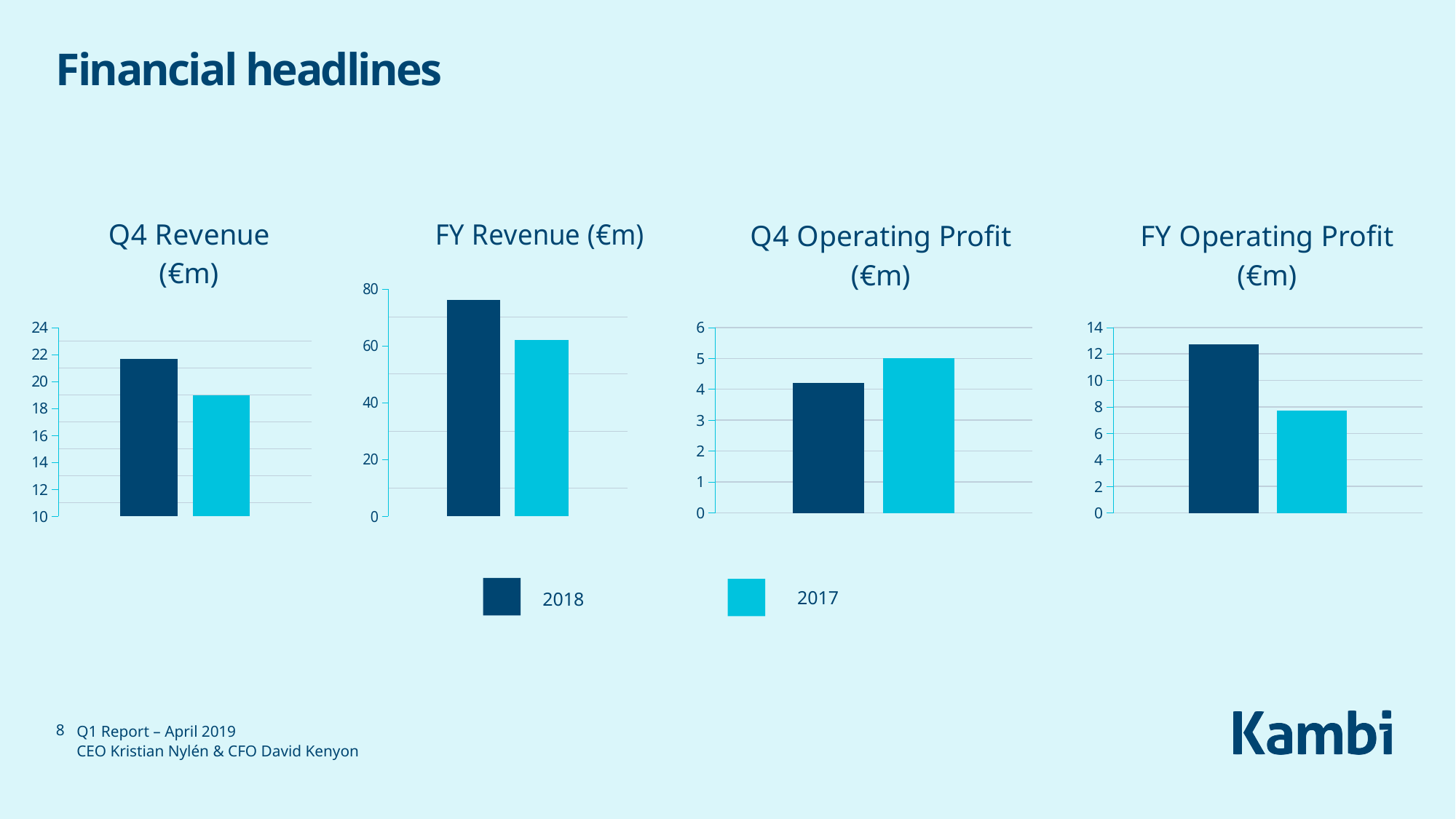
In the FY Operating Profit (€m) chart, is the value for 2017 greater or less than 8? less In the Q4 Revenue (€m) chart, is the value for 2018 greater or less than 20? greater In the Q4 Operating Profit (€m) chart, is the value for 2018 greater or less than 4? greater In the Q4 Revenue (€m) chart, which year has the higher value, 2018 or 2017? 2018 How many series does the shared legend list? 2 In the FY Operating Profit (€m) chart, which year has the lower value? 2017 In the Q4 Operating Profit (€m) chart, which year has the higher value, 2018 or 2017? 2017 What kind of chart is the FY Revenue (€m) chart? Bar chart How many charts are shown on the slide? 4